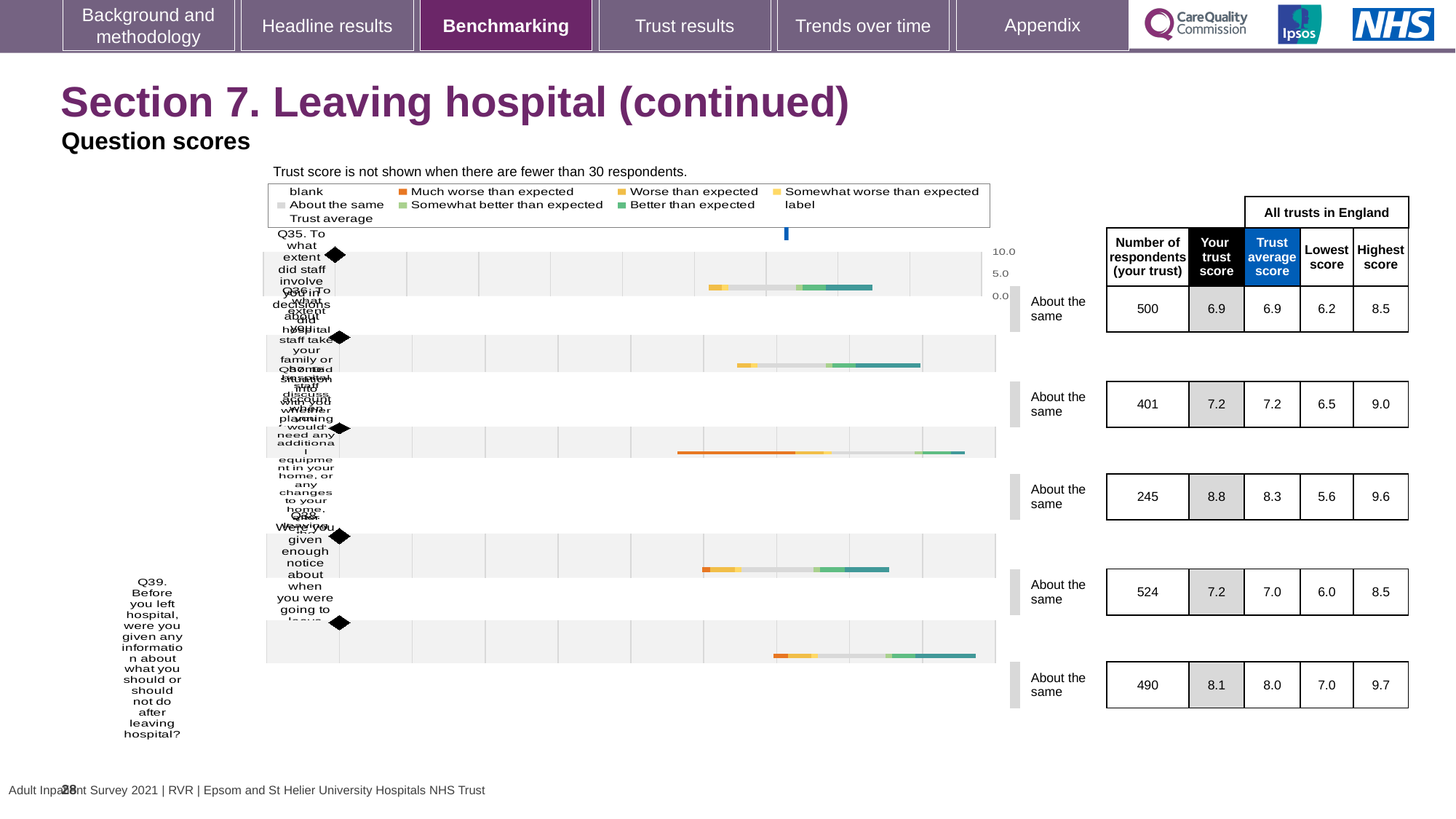
What is the highest score across all trusts in England for Q39 (the last row)? 9.7 What benchmark category is shown for every question in the chart? About the same What is the number of respondents for Q35 (the first row)? 500 What is the trust average score for Q36 (the second row)? 7.2 Which row has the lowest 'Your trust score'? Q35 (the first row, 6.9) What is the trust score for Q39 (the last row)? 8.1 What is the difference between the highest score and the lowest score for Q39 (the last row)? 2.7 What kind of chart is shown on the slide? bar chart How many questions (rows) are plotted in the chart? 5 Which is larger, the trust score for Q35 (first row) or the trust score for Q39 (last row)? Q39 (8.1) What is the lowest score across all trusts in England for the third row? 5.6 Which row has the highest 'Your trust score'? the third row (8.8)